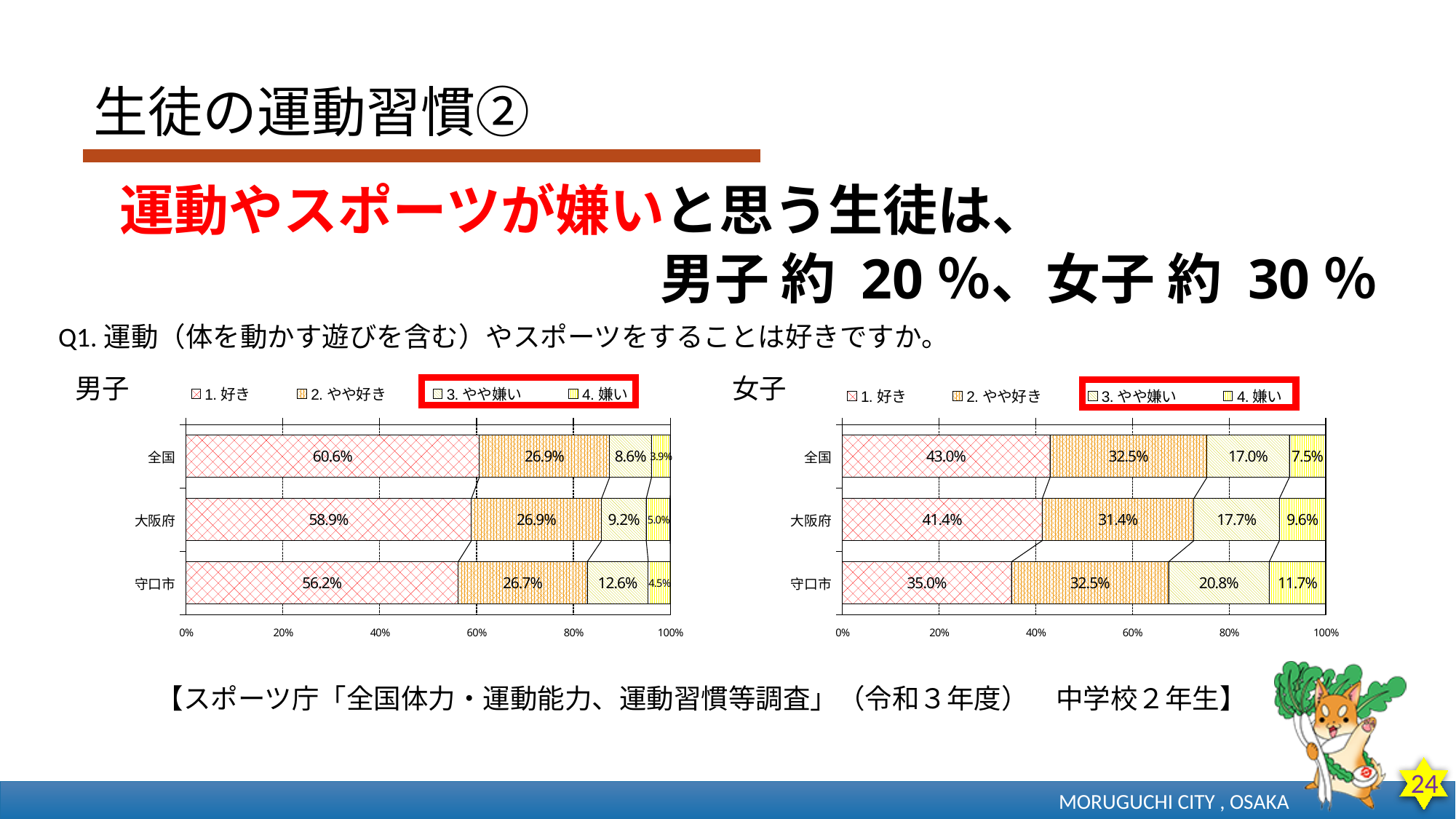
In the 女子 (girls) chart, what is the value of 3. やや嫌い for 大阪府? 17.7% In the 女子 (girls) chart, what is the difference between the 1. 好き values for 全国 and 守口市? 8.0% In the 女子 (girls) chart, is the 3. やや嫌い value for 守口市 larger or smaller than that for 全国? larger In the 男子 (boys) chart, what is the combined value of 3. やや嫌い and 4. 嫌い for 守口市? 17.1% How many categories are shown in the 女子 (girls) chart? 3 In the 女子 (girls) chart, what is the value of 4. 嫌い for 守口市? 11.7% In the 男子 (boys) chart, what is the value of 1. 好き for 守口市? 56.2% In the 男子 (boys) chart, which category has the highest value for 1. 好き? 全国 What type of chart is the 女子 (girls) chart? Stacked bar chart How many series does the legend of the 男子 (boys) chart list? 4 In the 女子 (girls) chart, which category has the lowest value for 1. 好き? 守口市 In the 男子 (boys) chart, what is the value of 2. やや好き for 全国? 26.9%